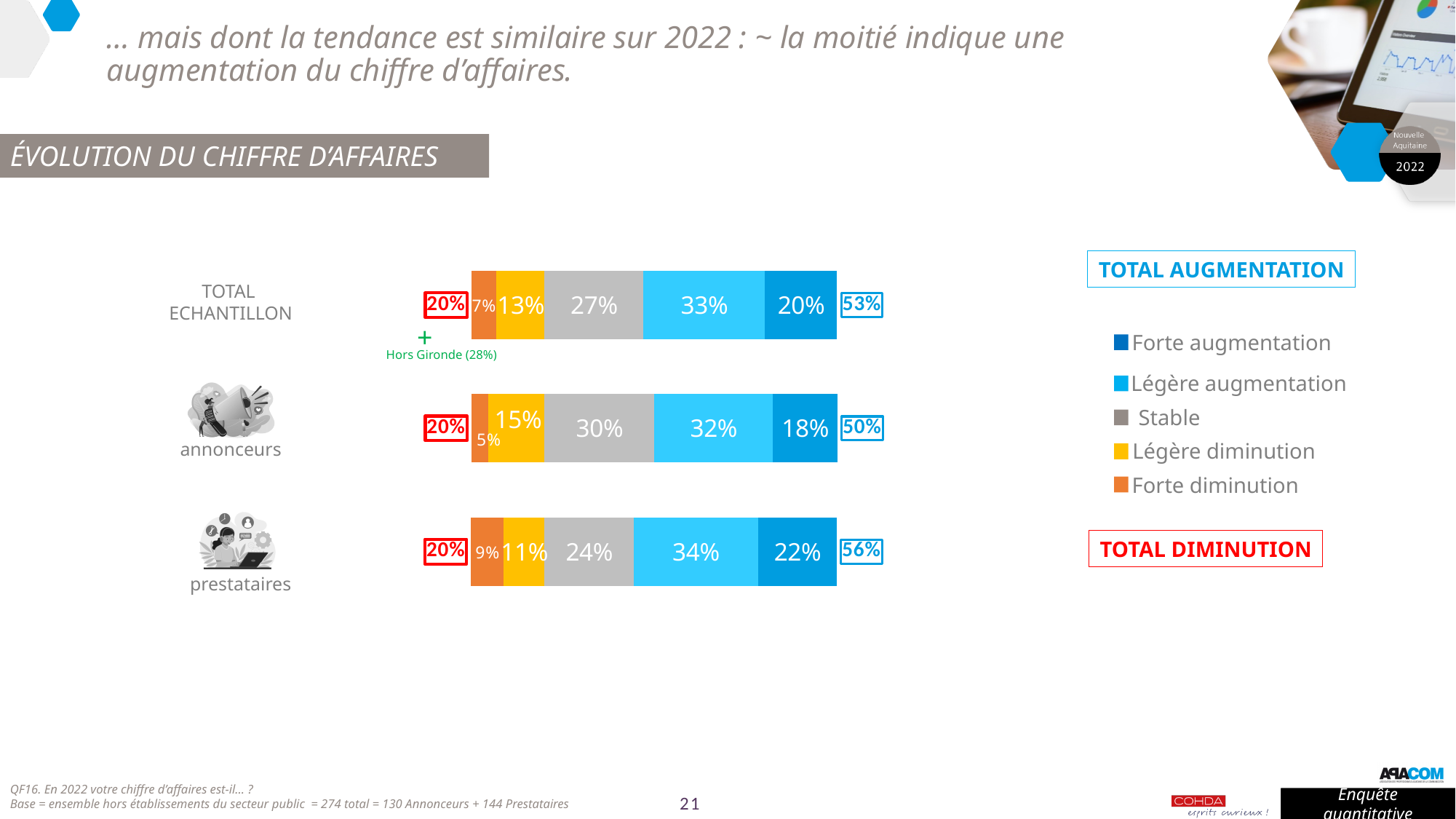
How many categories (bars) are plotted in the chart? 3 What is the value of 'Stable' for TOTAL ECHANTILLON? 27% What is the value of 'Légère augmentation' for prestataires? 34% What kind of chart is shown on the slide? Stacked bar chart Which category has the lowest 'Forte diminution' value? annonceurs Which category has the highest 'Stable' value? annonceurs What is the value of 'Forte diminution' for annonceurs? 5% How many series does the legend list? 5 Which is larger: 'Légère diminution' for annonceurs or for prestataires? annonceurs What is the 'Forte augmentation' value for annonceurs? 18% What is the difference between the 'Forte augmentation' values for prestataires and annonceurs? 4% What is the TOTAL AUGMENTATION value shown for prestataires? 56%